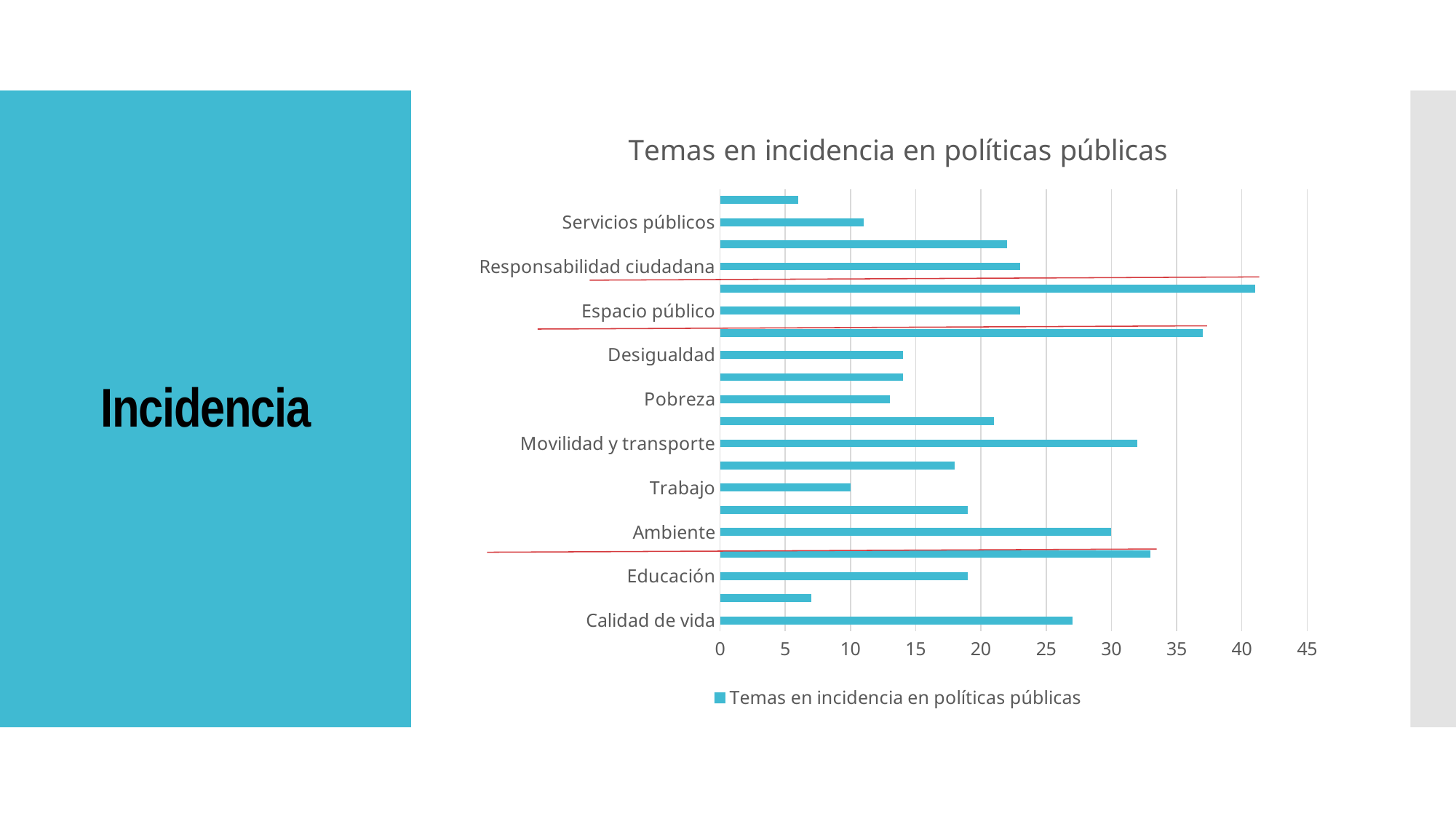
How many series does the legend list? 1 Is the value for Servicios públicos greater or less than 15? less What kind of chart is shown on the slide? bar chart Is the value for Calidad de vida greater or less than 25? greater What is the title of the chart? Temas en incidencia en políticas públicas Is the value for Movilidad y transporte greater or less than 30? greater Which has the larger value, Movilidad y transporte or Trabajo? Movilidad y transporte Which has the larger value, Calidad de vida or Pobreza? Calidad de vida Which has the larger value, Ambiente or Educación? Ambiente